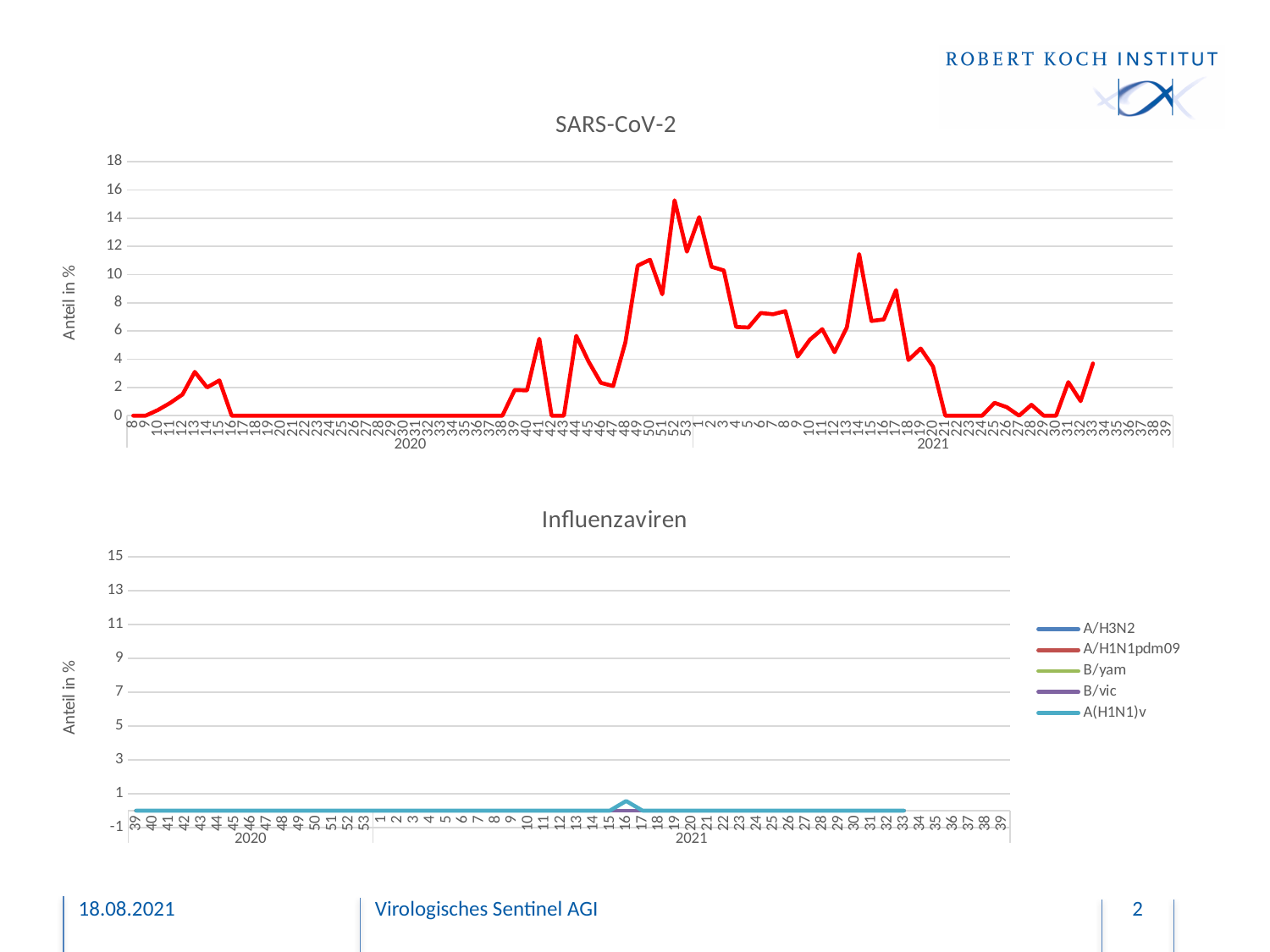
In the SARS-CoV-2 chart, do the values rise or fall from week 8 to week 13 of 2020? rise What kind of chart is the SARS-CoV-2 chart? line chart In the SARS-CoV-2 chart, which is larger: the value at week 52 of 2020 or the value at week 14 of 2021? week 52 of 2020 In the SARS-CoV-2 chart, is the value at week 14 of 2021 greater or less than 10? greater In the SARS-CoV-2 chart, is the value at week 25 of 2021 greater or less than 2? less In the SARS-CoV-2 chart, do the values generally rise or fall from week 1 of 2021 to week 22 of 2021? fall In the Influenzaviren chart, is the value of A(H1N1)v at week 16 of 2021 greater or less than 1? less How many series does the legend of the Influenzaviren chart list? 5 In the SARS-CoV-2 chart, at which week does the line reach its highest value? week 52 of 2020 What is the y-axis label of the Influenzaviren chart? Anteil in %